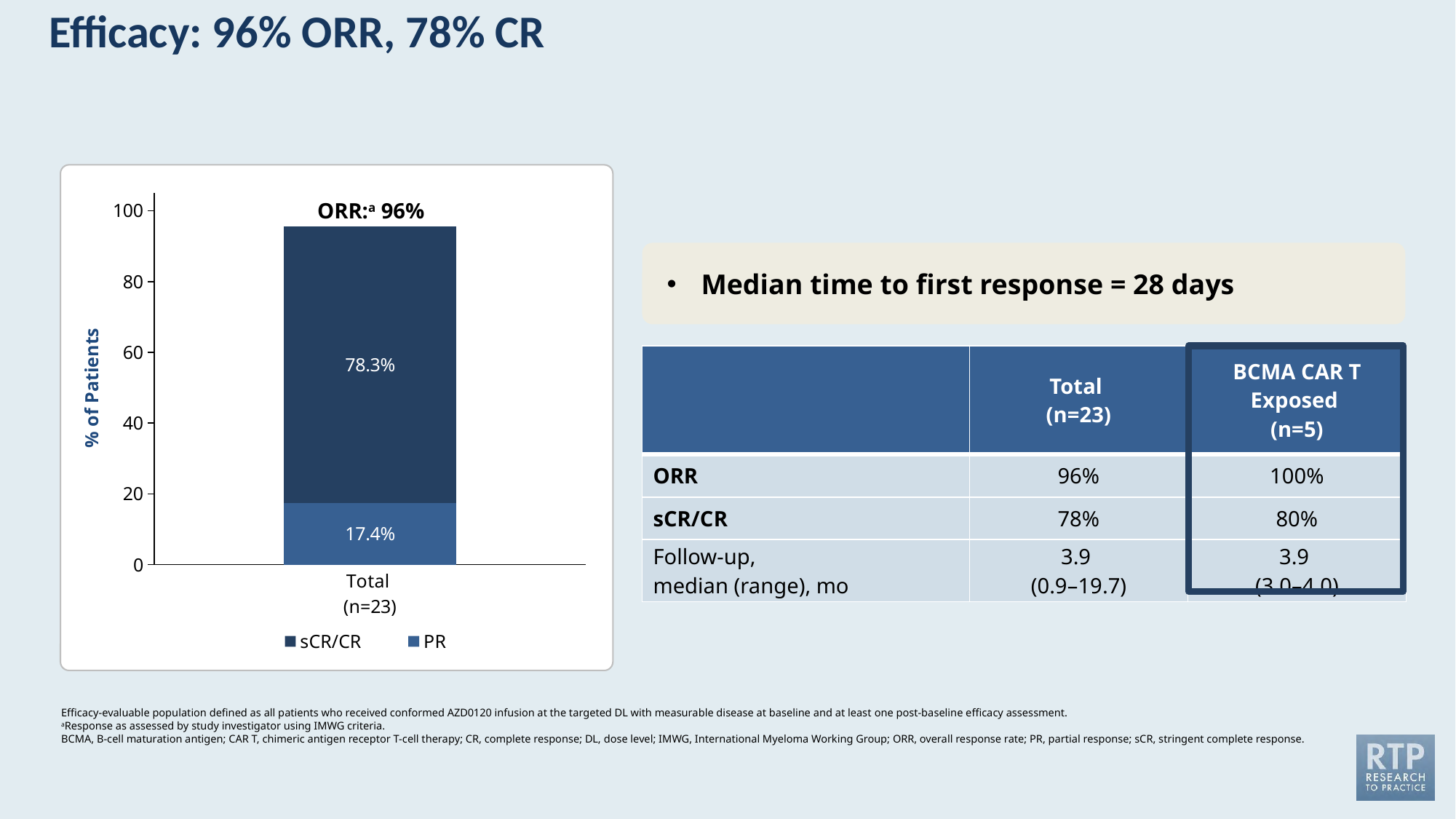
Which series has the smallest value in the bar chart? PR How many series does the legend of the bar chart list? 2 Is the top of the stacked bar for Total (n=23) greater or less than 80 on the y axis? greater What is the sum of the two segment labels (sCR/CR and PR) in the stacked bar? 95.7% What percentage of patients achieved sCR/CR according to the bar chart? 78.3% Which response category makes up the larger segment of the stacked bar, sCR/CR or PR? sCR/CR What kind of chart is shown on the left of the slide? Stacked bar chart How many categories are plotted on the x axis of the bar chart? 1 What is the difference in percentage points between the sCR/CR and PR segments of the bar? 60.9 What percentage of patients achieved PR according to the bar chart? 17.4% What ORR value is labelled above the bar in the chart? 96% What is the label of the y axis of the bar chart? % of Patients